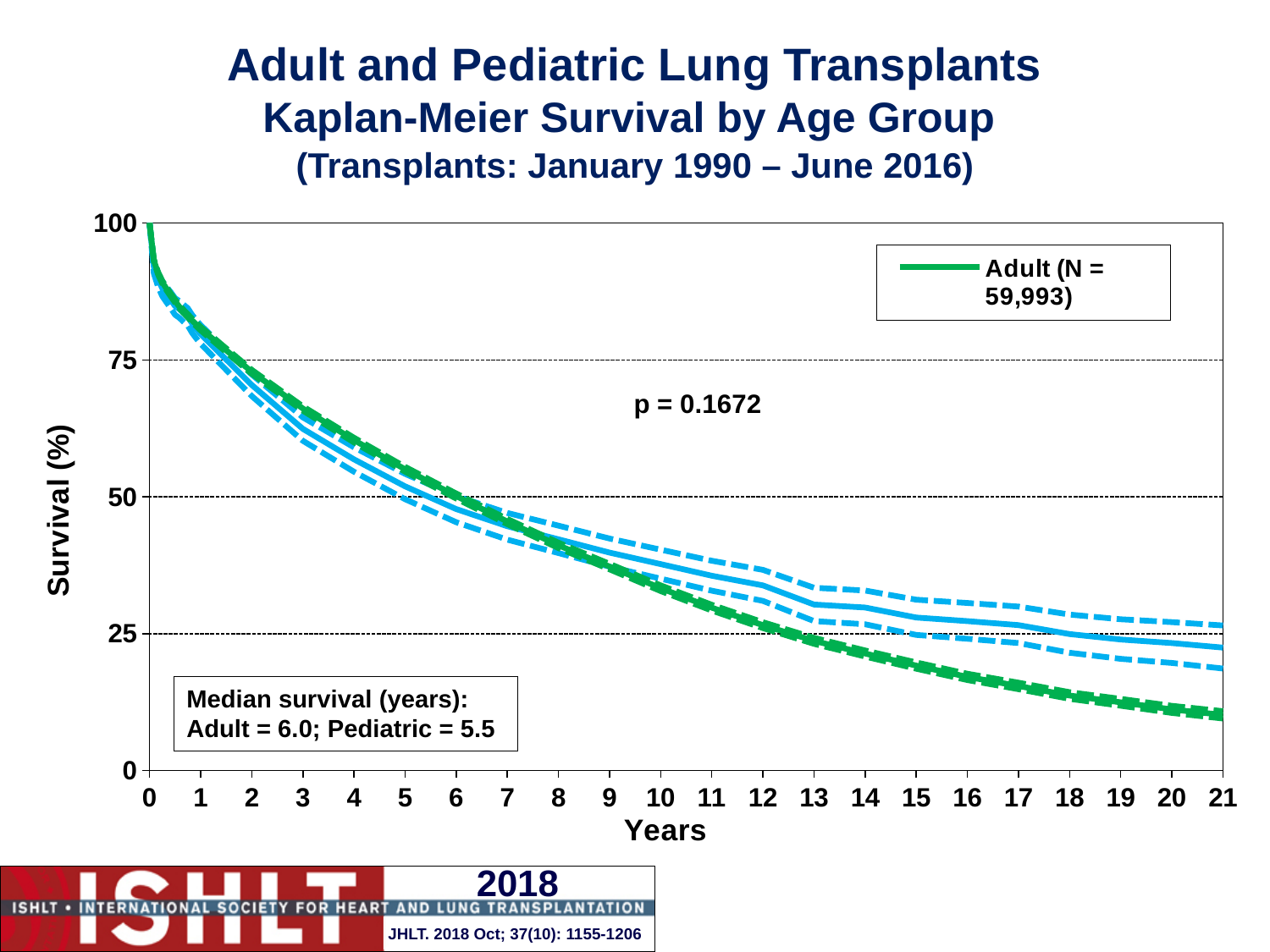
Is the Adult survival at 21 years greater or less than 25? less Is the Adult survival at 10 years greater or less than 50? less Is the Adult survival at 1 year greater or less than 75? greater What is the label of the y axis? Survival (%) What p-value is printed on the chart? p = 0.1672 What is the median survival in years for the Adult group? 6.0 Which group has the longer median survival, Adult or Pediatric? Adult What is the difference in median survival (years) between the Adult and Pediatric groups? 0.5 What is the N for the Adult group shown in the legend? 59,993 What kind of chart is shown on the slide? Line chart What is the median survival in years for the Pediatric group? 5.5 Does the Adult survival curve rise or fall as the years increase? Fall